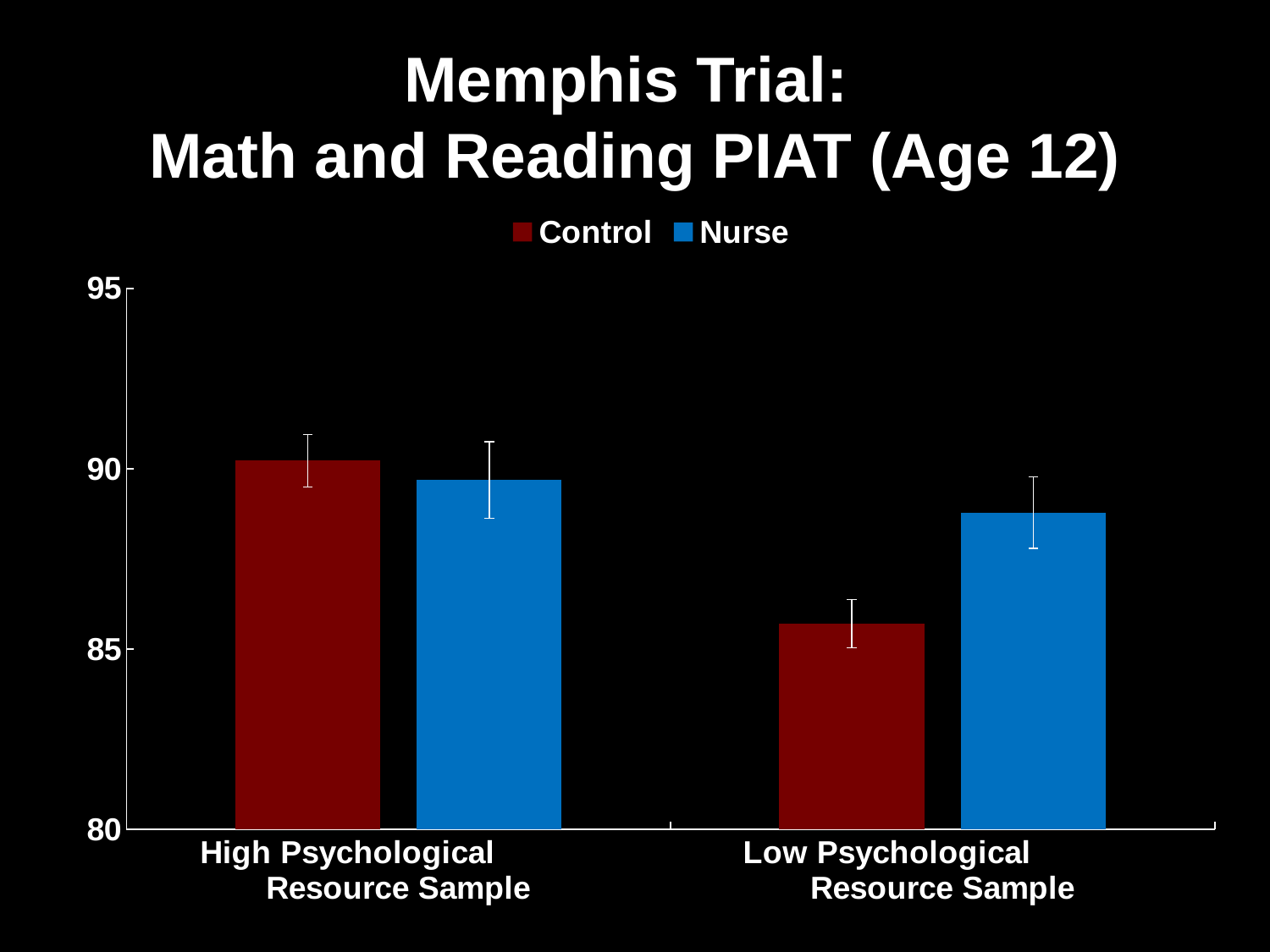
Is the Control value for the High Psychological Resource Sample greater or less than 85? greater What kind of chart is shown on the slide? bar chart Is the Nurse value for the Low Psychological Resource Sample greater or less than 90? less Is the Nurse value for the Low Psychological Resource Sample greater or less than 85? greater In the Low Psychological Resource Sample, which is larger, Control or Nurse? Nurse How many categories are shown on the x axis? 2 What is the title of the chart? Memphis Trial: Math and Reading PIAT (Age 12) Which series is shown in blue? Nurse Which bar is the lowest on the chart? Control, Low Psychological Resource Sample How many series does the legend list? 2